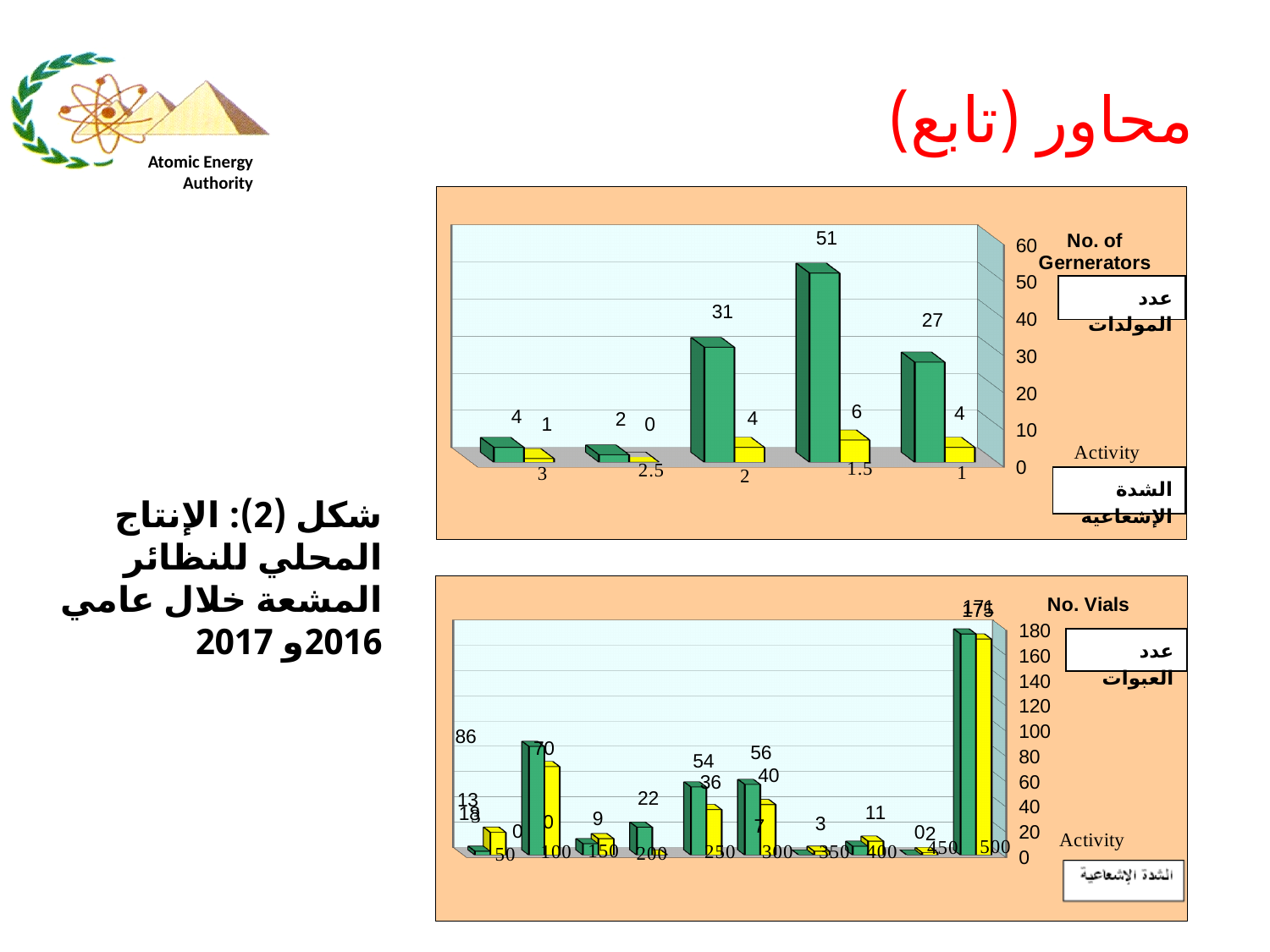
In the top chart (No. of Generators), what is the value of the green bar at activity 2? 31 In the bottom chart (No. Vials), at which activity value are the bars highest? 500 In the top chart (No. of Generators), what is the value of the yellow bar at activity 1.5? 6 In the top chart (No. of Generators), at which activity value is the green bar highest? 1.5 What kind of chart is the top chart (No. of Generators)? bar chart In the top chart (No. of Generators), which is larger: the green bar at activity 1.5 or the green bar at activity 1? activity 1.5 In the top chart (No. of Generators), what is the difference between the green bars at activity 1.5 and activity 2? 20 In the bottom chart (No. Vials), what is the value of the green bar at activity 250? 54 How many activity categories are shown on the x axis of the top chart (No. of Generators)? 5 How many activity categories are shown on the x axis of the bottom chart (No. Vials)? 10 In the top chart (No. of Generators), what is the value of the green bar at activity 1.5? 51 In the bottom chart (No. Vials), what is the value of the yellow bar at activity 300? 40